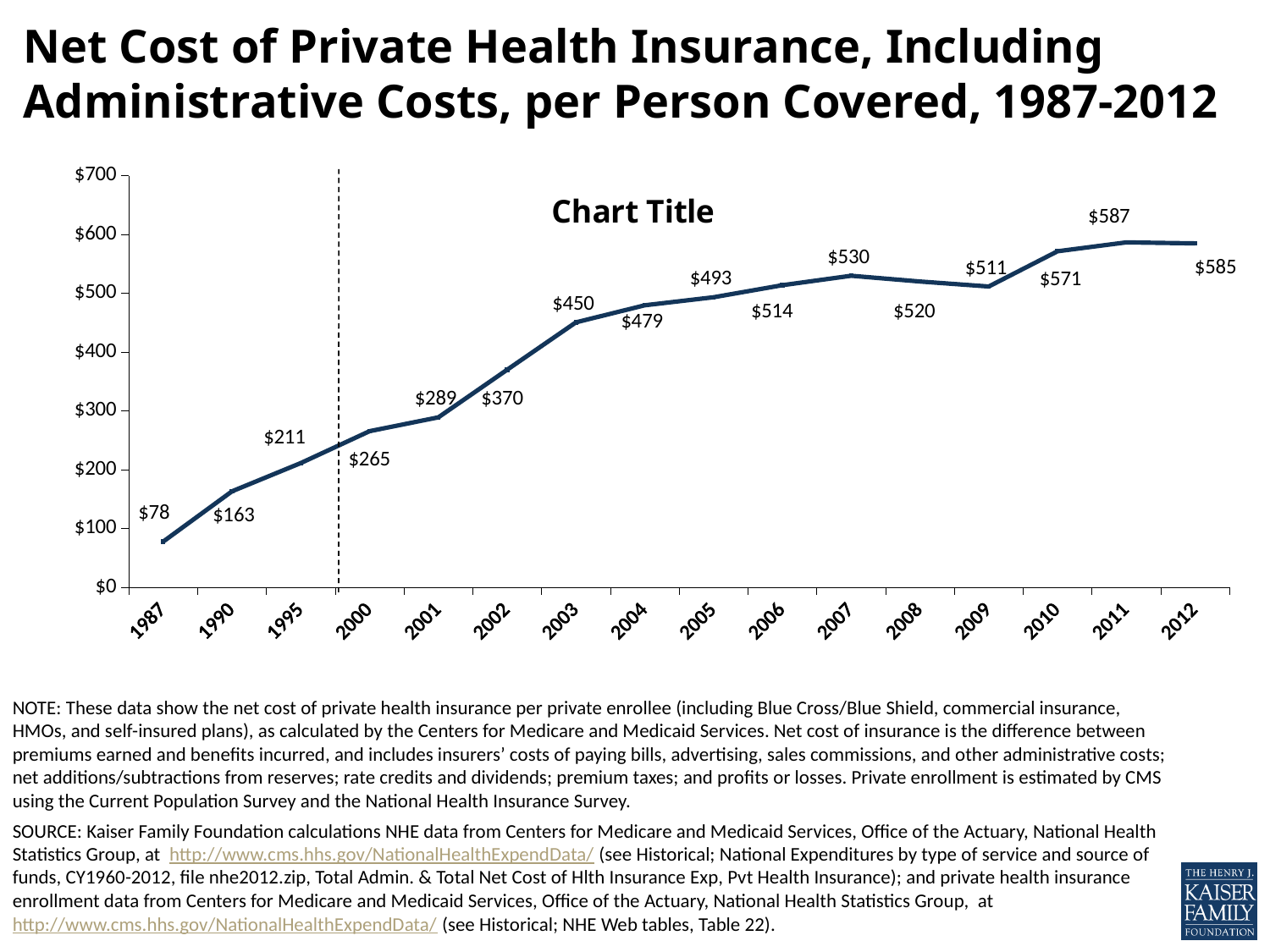
How many years are plotted on the x axis? 16 Is the value for 2003 greater or less than $400? greater What is the value shown for 2007? $530 What is the difference between the values for 2010 and 2009? $60 What is the value shown for 2012? $585 Which year has the lowest value on the chart? 1987 What is the difference between the values for 2000 and 1987? $187 Do the values generally rise or fall from 1987 to 2012? rise What is the net cost of private health insurance per person covered in 1987? $78 What kind of chart is shown on the slide? line chart Which is larger, the value for 2007 or the value for 2008? 2007 What is the value shown for 2002? $370